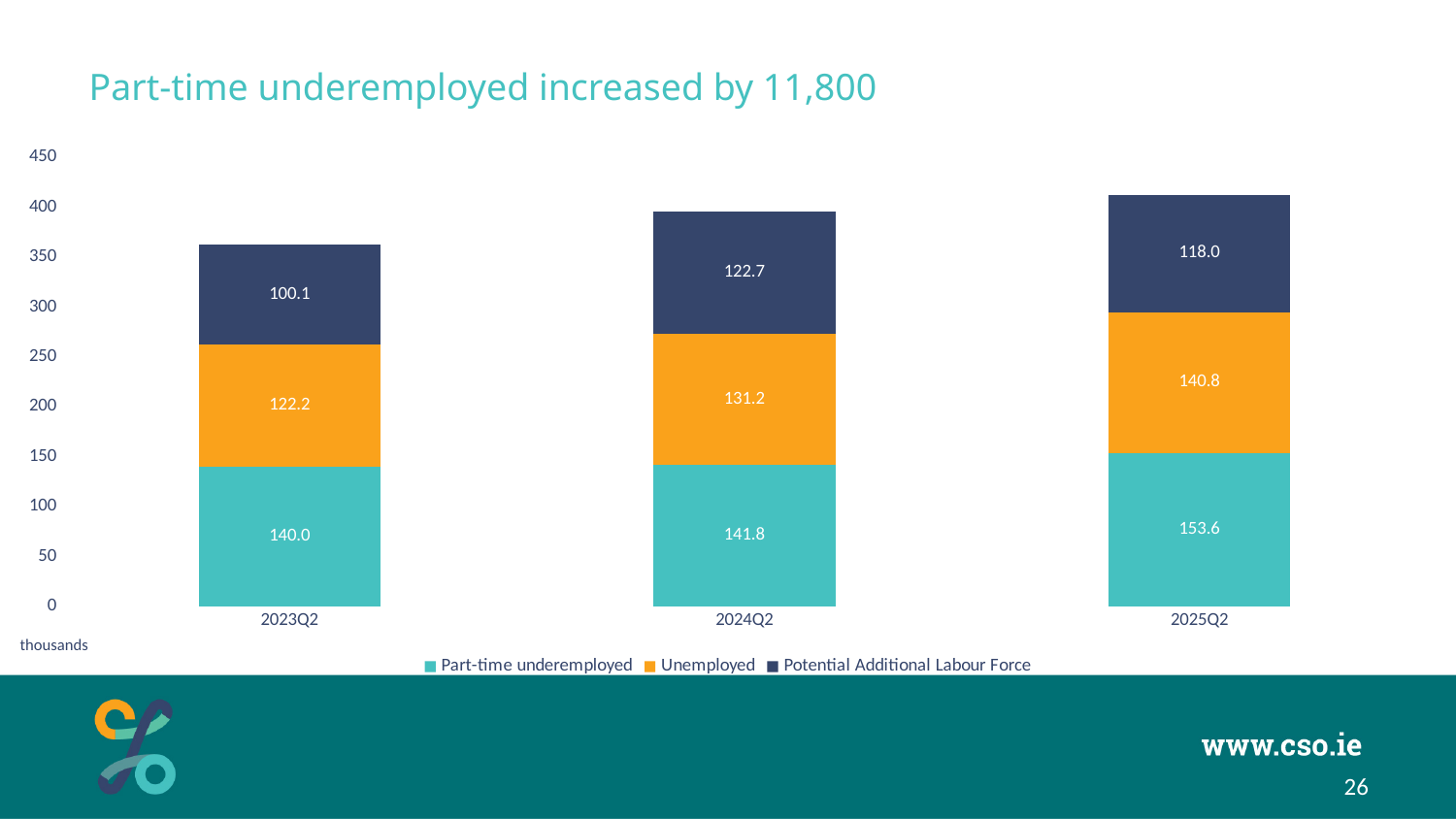
Which is larger: Unemployed in 2025Q2 or Potential Additional Labour Force in 2025Q2? Unemployed in 2025Q2 What is the value for Potential Additional Labour Force in 2023Q2? 100.1 By how much did the Part-time underemployed value change from 2024Q2 to 2025Q2? 11.8 What is the total of the stacked bar for 2025Q2? 412.4 What type of chart is shown on the slide? Stacked bar chart What is the value for Unemployed in 2024Q2? 131.2 In which quarter is the Unemployed value lowest? 2023Q2 What is the value for Part-time underemployed in 2025Q2? 153.6 In which quarter is the Potential Additional Labour Force value highest? 2024Q2 How many series does the legend list? 3 What is the difference between the Unemployed values in 2025Q2 and 2023Q2? 18.6 What is the total of the stacked bar for 2024Q2? 395.7